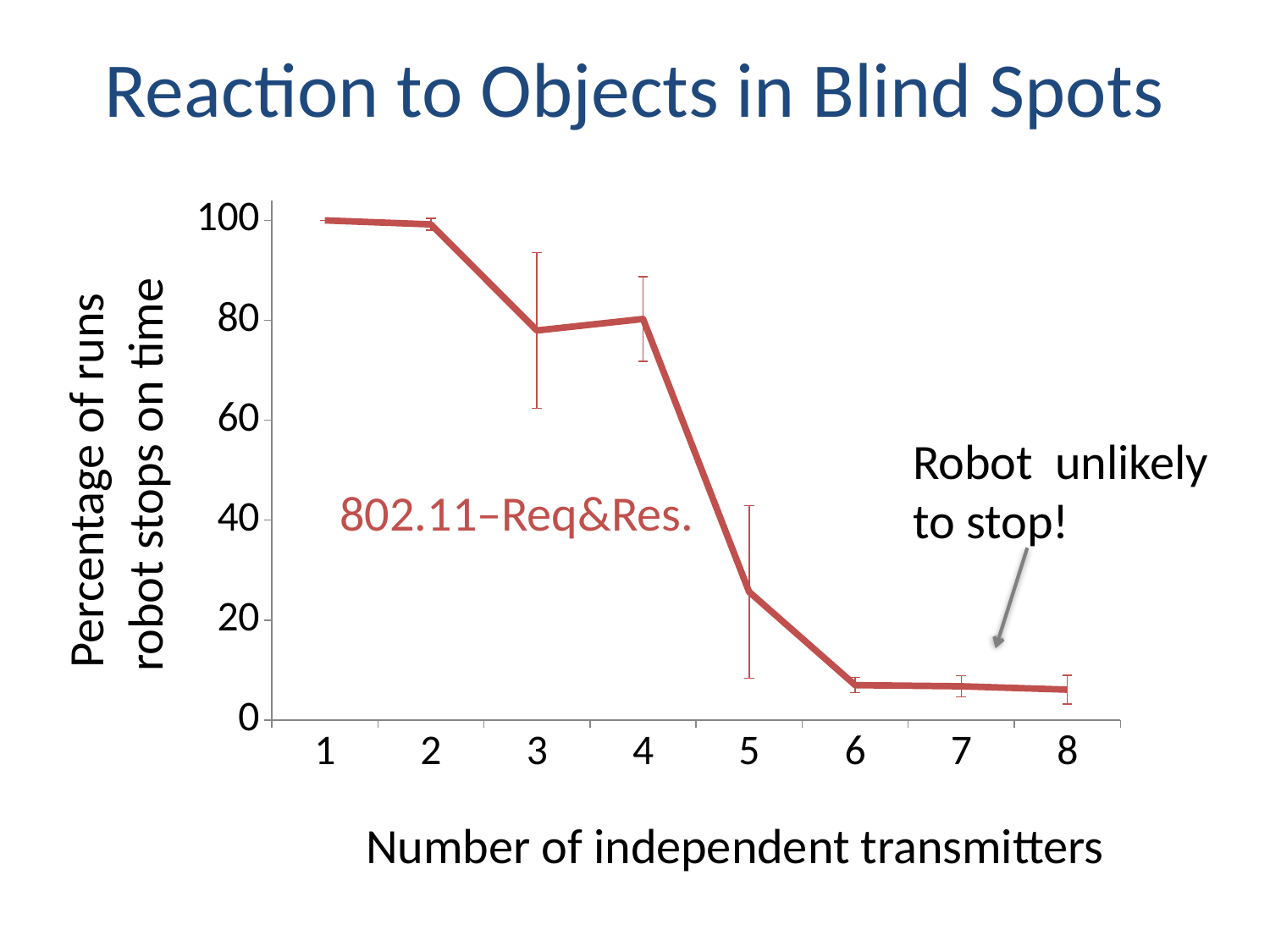
How many data points are plotted along the x axis? 8 What is the label of the x axis? Number of independent transmitters What is the percentage of runs the robot stops on time with 1 independent transmitter? 100 Is the value for 3 independent transmitters greater or less than 80? less Is the value for 5 independent transmitters greater or less than 40? less What is the name of the plotted series written in red on the chart? 802.11–Req&Res. Do the values rise or fall as the number of independent transmitters increases? fall What kind of chart is shown on the slide? line chart Which has a higher percentage of runs the robot stops on time: 2 transmitters or 5 transmitters? 2 transmitters Is the value for 6 independent transmitters greater or less than 20? less Which number of independent transmitters has the highest percentage of runs the robot stops on time? 1